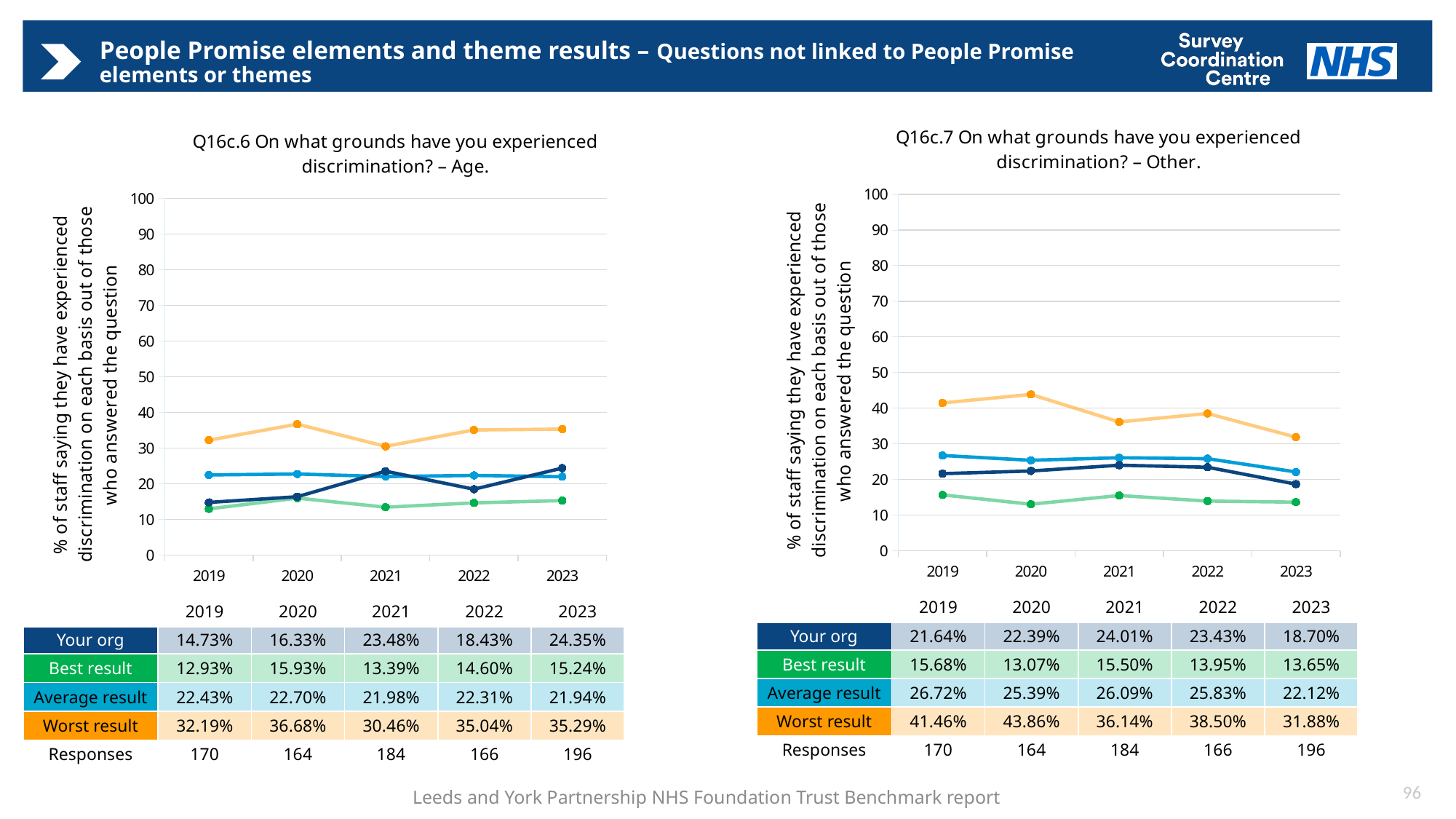
In the Q16c.6 Age chart, in which year is the 'Your org' value highest? 2023 In the Q16c.6 Age chart, is the 'Worst result' value for 2021 greater or less than 40? less In the Q16c.7 Other chart, does the 'Average result' value rise or fall from 2022 to 2023? fall In the Q16c.7 Other chart, what is the 'Worst result' value for 2020? 43.86% In the Q16c.7 Other chart, which is larger in 2021: 'Your org' or 'Average result'? Average result How many series are shown in the Q16c.6 Age chart? 4 In the Q16c.6 Age chart, what is the difference between the 'Worst result' and 'Best result' values for 2020? 20.75% In the Q16c.6 Age chart, what is the 'Your org' value for 2023? 24.35% What type of chart is the Q16c.7 Other chart? line chart In the Q16c.6 Age chart, what is the number of responses for 2021? 184 In the Q16c.7 Other chart, in which year is the 'Worst result' value lowest? 2023 How many years are plotted on the x axis of the Q16c.7 Other chart? 5